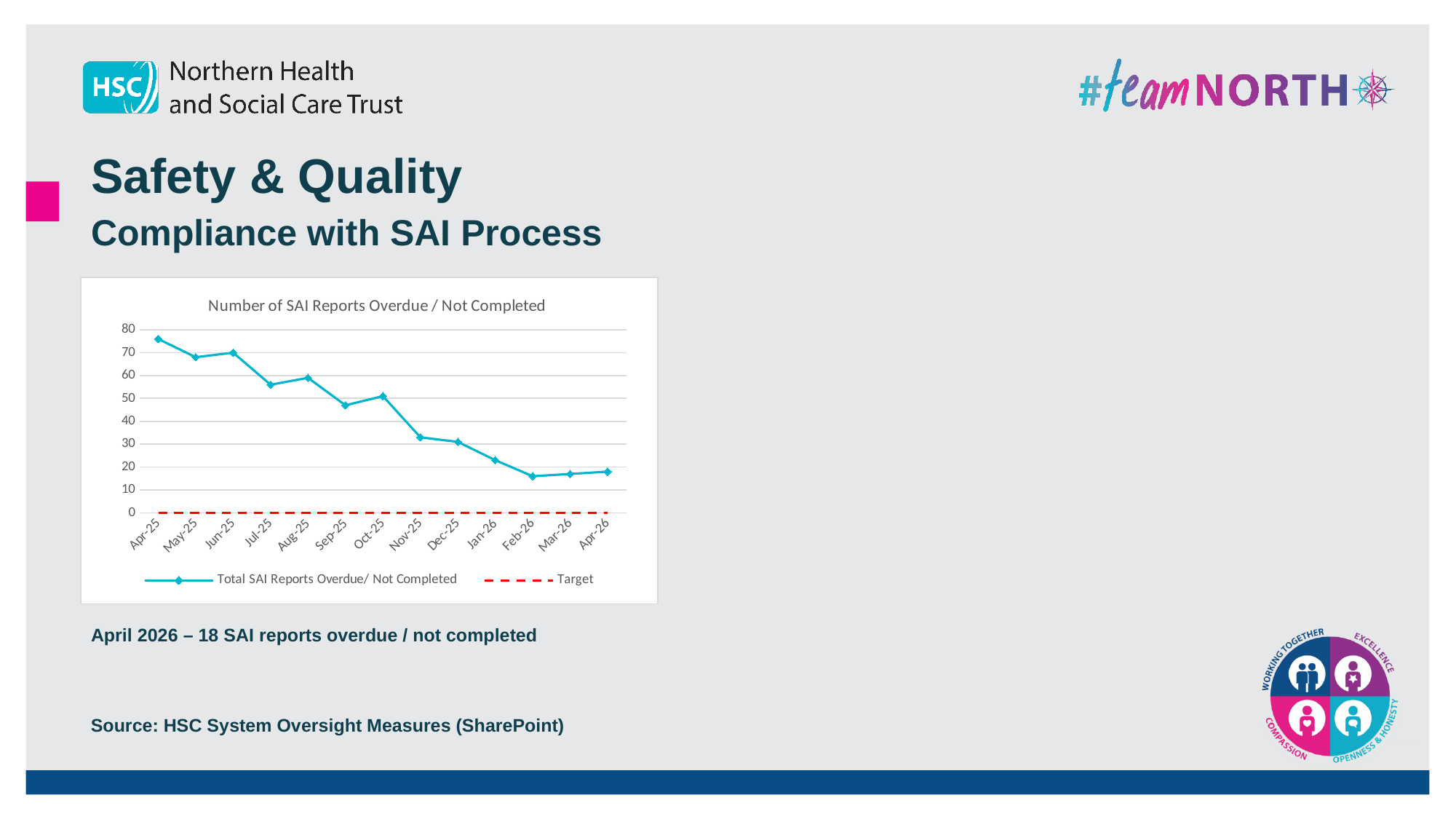
Is the value for Jul-25 greater or less than 60? less What value does the Target line sit at? 0 What kind of chart is shown on the slide? line chart Is the value for Apr-25 greater or less than 70? greater Which is larger, the value for Jun-25 or the value for Sep-25? Jun-25 What is the title of the chart? Number of SAI Reports Overdue / Not Completed Is the value for Dec-25 greater or less than 40? less Do the values for Total SAI Reports Overdue/ Not Completed generally rise or fall from Apr-25 to Apr-26? fall How many series does the chart legend list? 2 Which month has the highest number of SAI reports overdue / not completed? Apr-25 How many monthly data points are plotted on the chart? 13 What is the value of Total SAI Reports Overdue/ Not Completed for Apr-26? 18